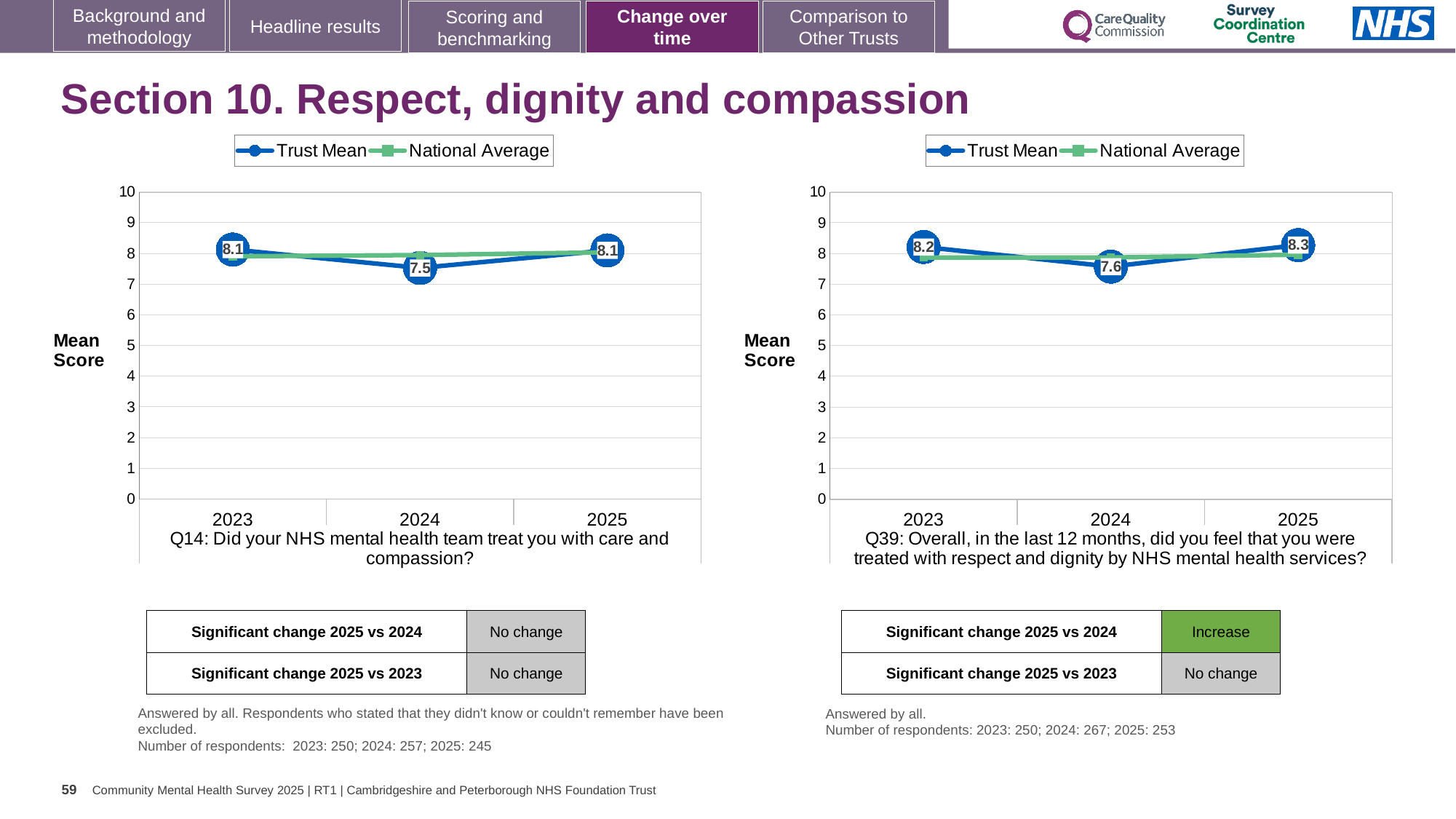
On the right chart (Q39), which year has the lowest Trust Mean? 2024 On the left chart (Q14), what is the Trust Mean for 2024? 7.5 How many series does the legend of the left chart (Q14) list? 2 On the left chart (Q14), is the National Average for 2024 greater or less than 5? greater On the right chart (Q39), what is the Trust Mean for 2025? 8.3 On the right chart (Q39), what is the Trust Mean for 2023? 8.2 On the right chart (Q39), is the Trust Mean for 2025 larger or smaller than the Trust Mean for 2024? larger On the left chart (Q14), what is the Trust Mean for 2025? 8.1 On the right chart (Q39), what is the difference between the Trust Mean in 2025 and in 2024? 0.7 On the left chart (Q14), what is the difference between the Trust Mean in 2023 and in 2024? 0.6 What type of chart is the right chart (Q39)? Line chart On the left chart (Q14), which year has the lowest Trust Mean? 2024